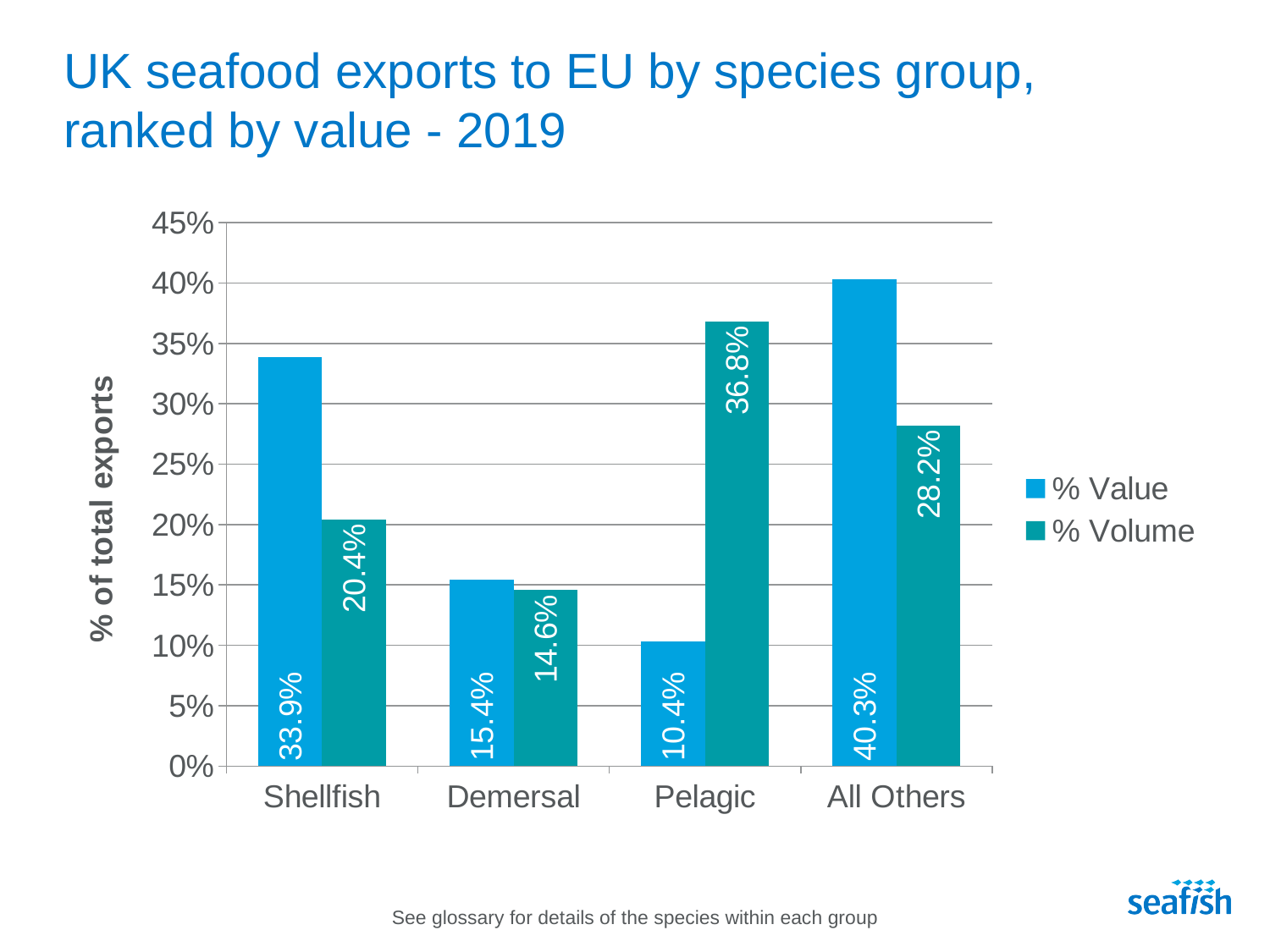
What is the % Volume for Pelagic? 36.8% What is the % Volume for Demersal? 14.6% What is the % Value for All Others? 40.3% For Shellfish, which is larger: % Value or % Volume? % Value How many series does the legend list? 2 Which species group has the highest % Value? All Others What kind of chart is shown on the slide? Bar chart How many species groups are shown on the x axis? 4 Which species group has the lowest % Value? Pelagic Which species group has the lowest % Volume? Demersal What is the % Value for Shellfish? 33.9% What is the difference between the % Volume and % Value for Pelagic? 26.4%